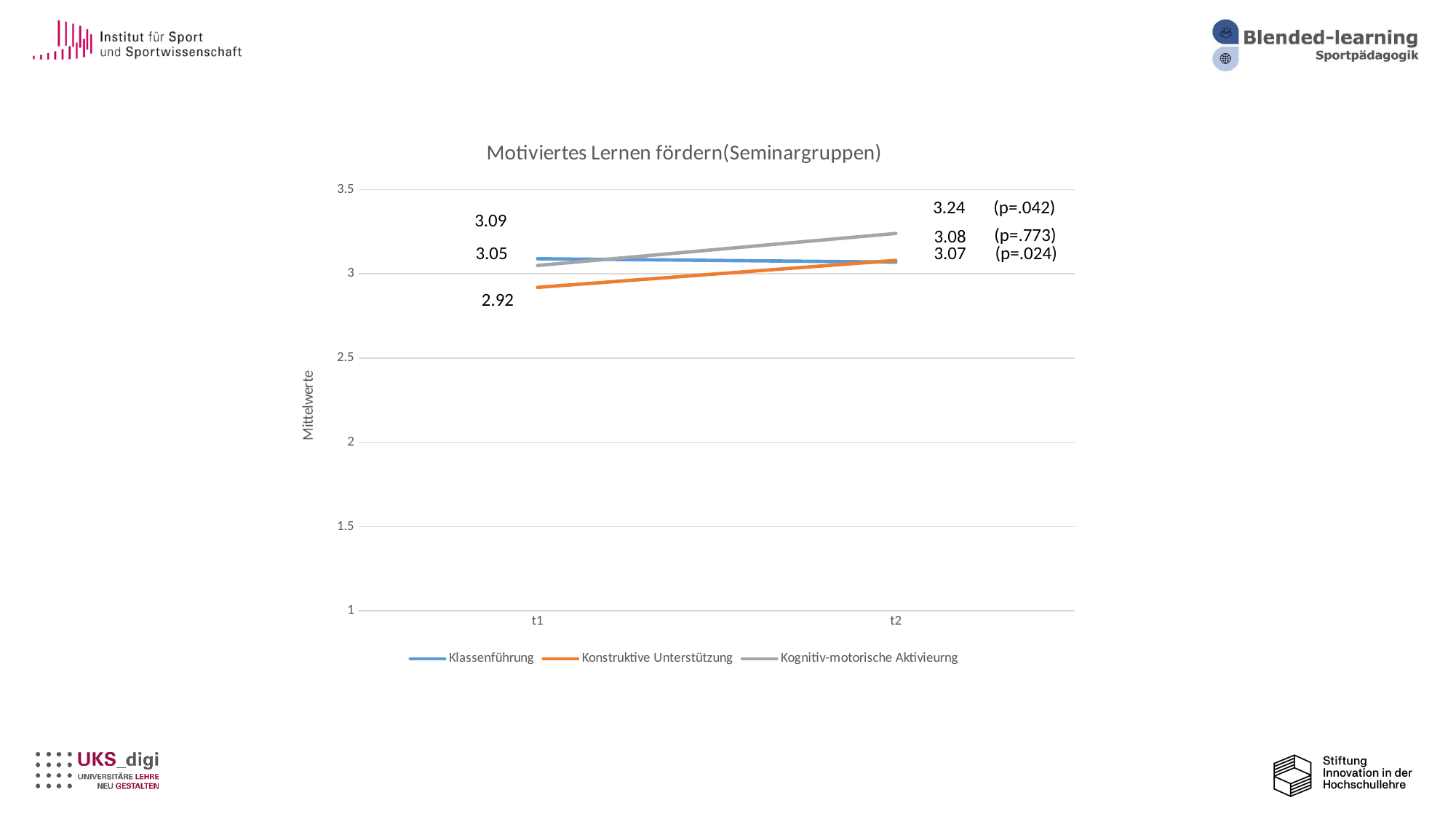
What is the value for Klassenführung at t1? 3.09 Which series has the lowest value at t1? Konstruktive Unterstützung How many time points are shown on the x axis? 2 What is the value for Kognitiv-motorische Aktivieurng at t2? 3.24 How many series does the legend list? 3 What is the value for Konstruktive Unterstützung at t1? 2.92 Does the Kognitiv-motorische Aktivieurng line rise or fall from t1 to t2? rise What is the label of the y axis? Mittelwerte Which series has the highest value at t2? Kognitiv-motorische Aktivieurng Is the value for Konstruktive Unterstützung at t1 greater or less than 3? less What is the title of the chart? Motiviertes Lernen fördern(Seminargruppen) What kind of chart is shown on the slide? line chart